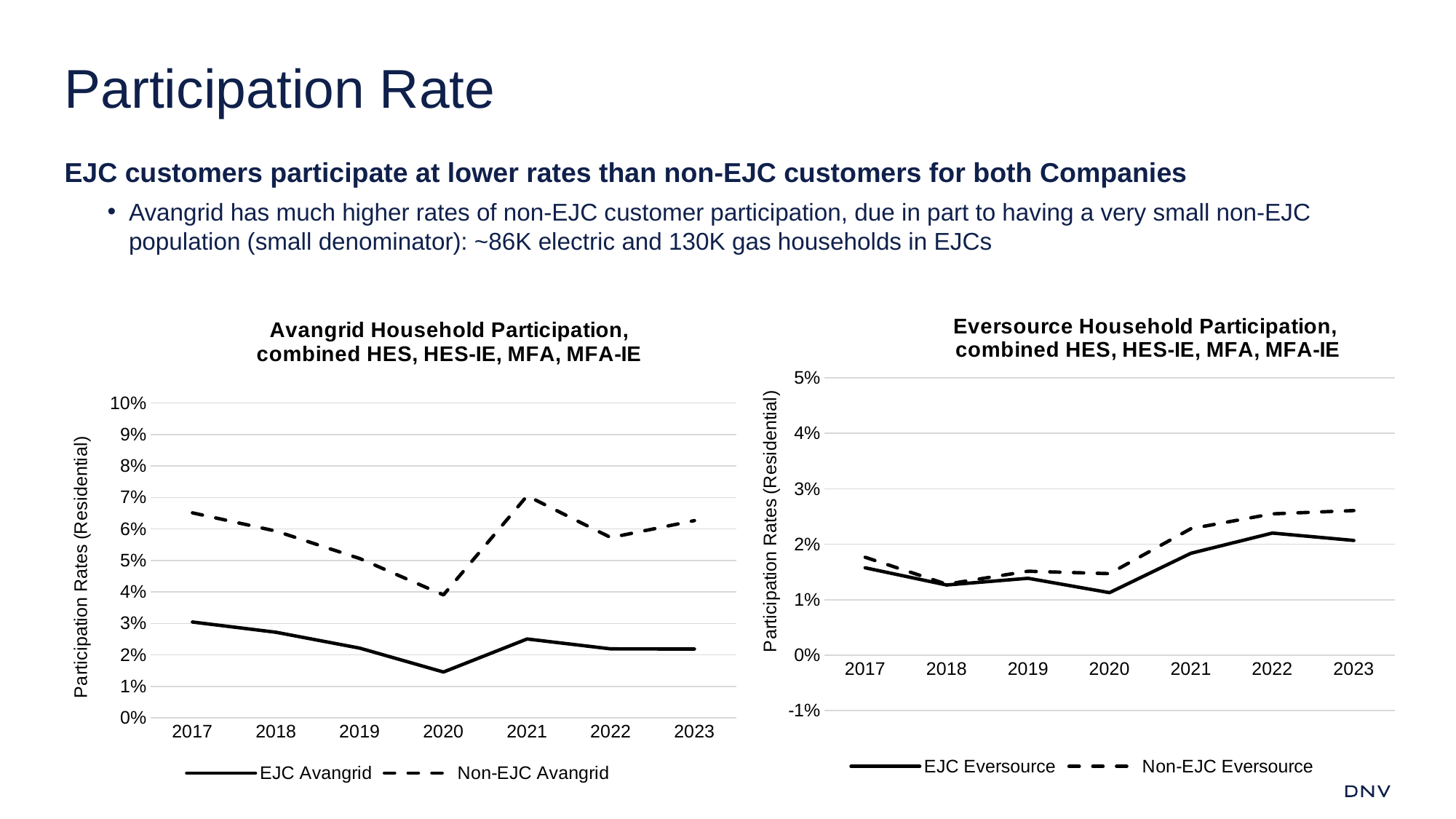
In the Avangrid Household Participation chart, does the EJC Avangrid line rise or fall from 2017 to 2020? Fall In the Eversource Household Participation chart, which year has the lowest EJC Eversource participation rate? 2020 In the Eversource Household Participation chart, which series has the larger value in 2021, EJC Eversource or Non-EJC Eversource? Non-EJC Eversource What kind of chart is the Avangrid Household Participation chart? Line chart In the Avangrid Household Participation chart, is the Non-EJC Avangrid value for 2021 greater or less than 6%? greater How many years are plotted on the x axis of the Eversource Household Participation chart? 7 In the Avangrid Household Participation chart, which year has the lowest EJC Avangrid participation rate? 2020 How many series does the legend of the Avangrid Household Participation chart list? 2 In the Eversource Household Participation chart, is the Non-EJC Eversource value for 2022 greater or less than 2%? greater In the Avangrid Household Participation chart, which year has the highest Non-EJC Avangrid participation rate? 2021 In the Avangrid Household Participation chart, which year has the lowest Non-EJC Avangrid participation rate? 2020 In the Avangrid Household Participation chart, is the EJC Avangrid value for 2020 greater or less than 2%? less